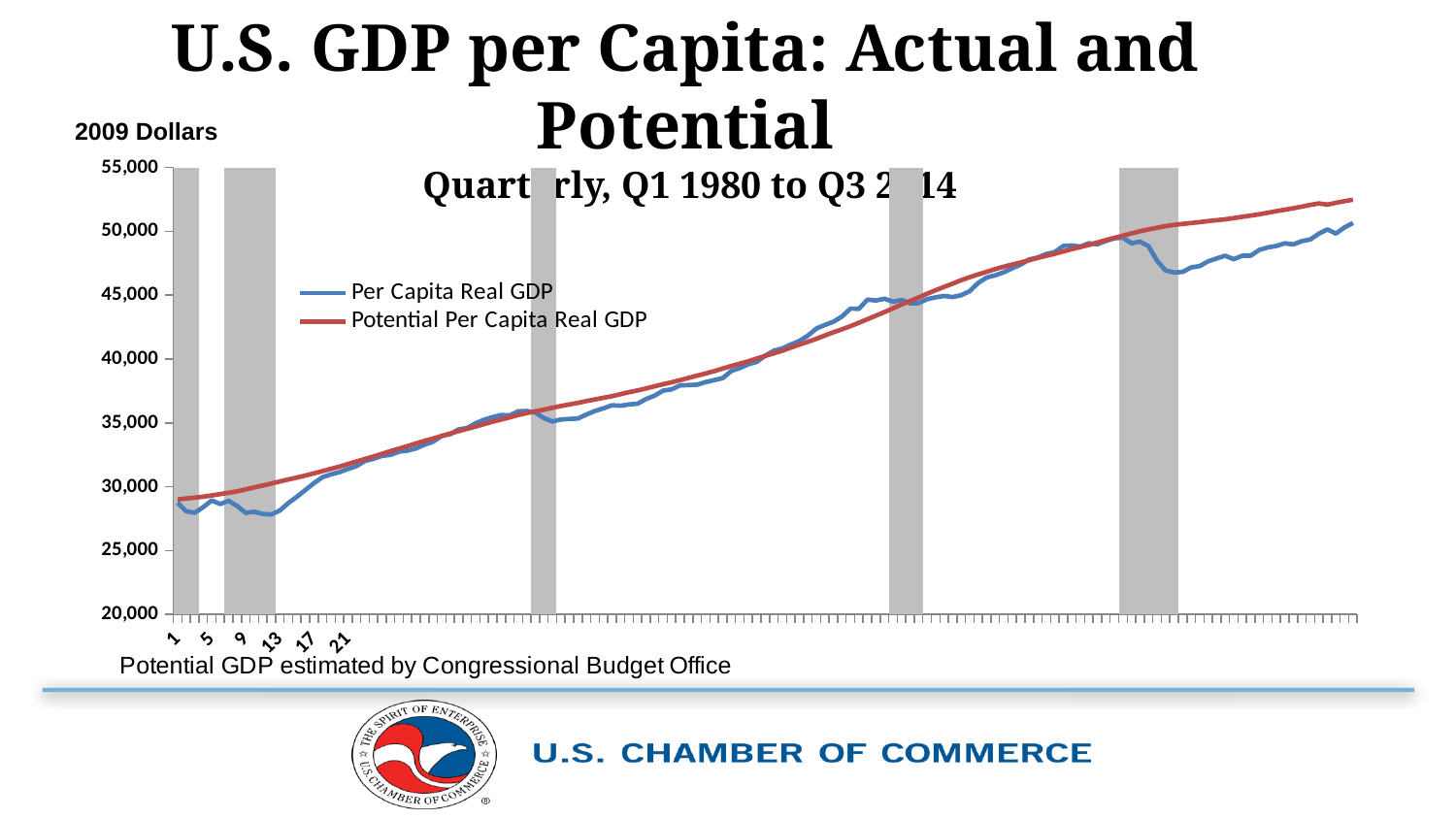
Is the lowest value of Per Capita Real GDP greater or less than 25,000? greater Do the values of Per Capita Real GDP generally rise or fall from left to right along the x axis? rise Is the value of Potential Per Capita Real GDP at the end of the series greater or less than 50,000? greater What is the highest value shown on the y axis? 55,000 At the right end of the chart, which series is higher: Per Capita Real GDP or Potential Per Capita Real GDP? Potential Per Capita Real GDP What colour is the Potential Per Capita Real GDP line? red Does the Potential Per Capita Real GDP line rise or fall across the chart? rise What are the two series named in the legend? Per Capita Real GDP and Potential Per Capita Real GDP What kind of chart is shown on the slide? line chart How many series does the legend list? 2 Is the value of Per Capita Real GDP at the end of the series greater or less than 45,000? greater